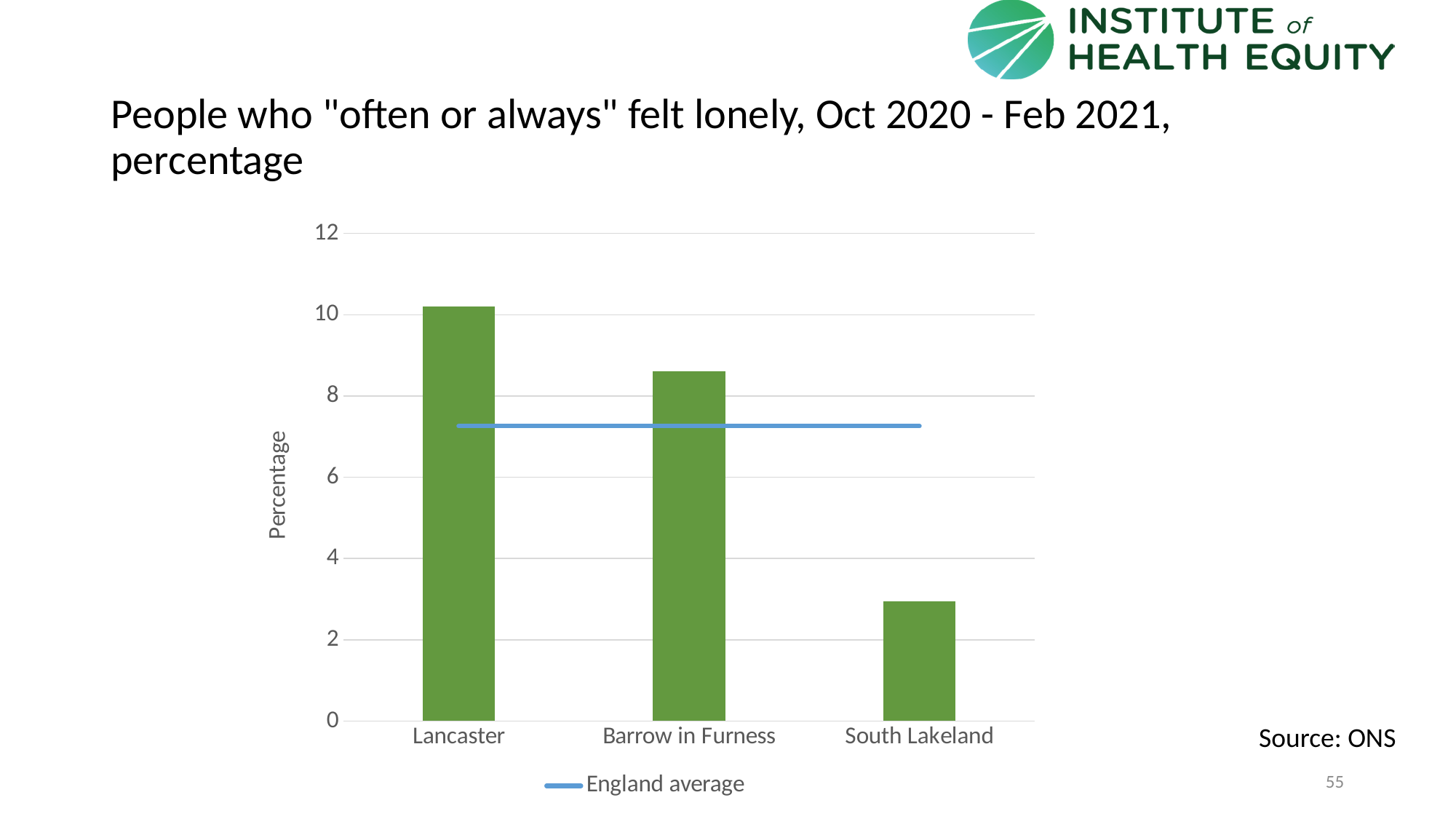
Which has the larger value, Lancaster or Barrow in Furness? Lancaster Is the England average line greater or less than 8? less What kind of chart is shown on the slide? Bar chart Do the bar values rise or fall from left to right across the x axis? Fall Which area has the highest percentage of people who "often or always" felt lonely? Lancaster Is the value for South Lakeland greater or less than 4? less How many areas are shown as bars on the chart? 3 What is the label of the horizontal line shown in the legend? England average Which has the larger value, Barrow in Furness or South Lakeland? Barrow in Furness Which area has the lowest percentage of people who "often or always" felt lonely? South Lakeland Is the value for Barrow in Furness greater or less than 8? greater